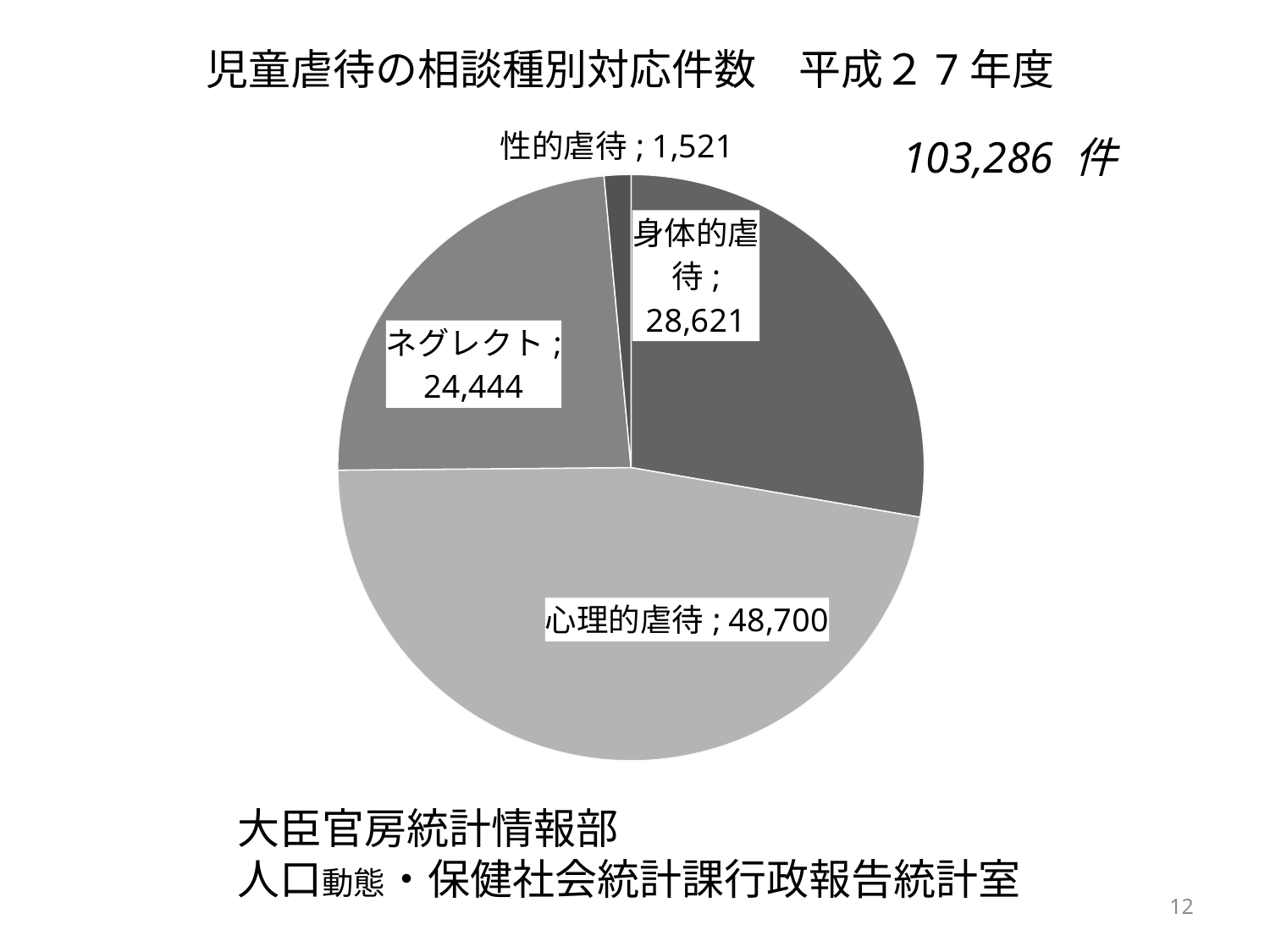
Which is larger, 身体的虐待 or ネグレクト? 身体的虐待 What is the difference between 心理的虐待 and 身体的虐待? 20,079 What type of chart is shown on the slide? pie chart What total number of cases is shown on the slide? 103,286 件 Which category has the smallest slice? 性的虐待 What is the value for 性的虐待? 1,521 Which category has the largest slice? 心理的虐待 How many slices does the pie chart have? 4 What is the difference between 身体的虐待 and ネグレクト? 4,177 What is the value for ネグレクト? 24,444 What is the value for 身体的虐待? 28,621 What is the value for 心理的虐待? 48,700